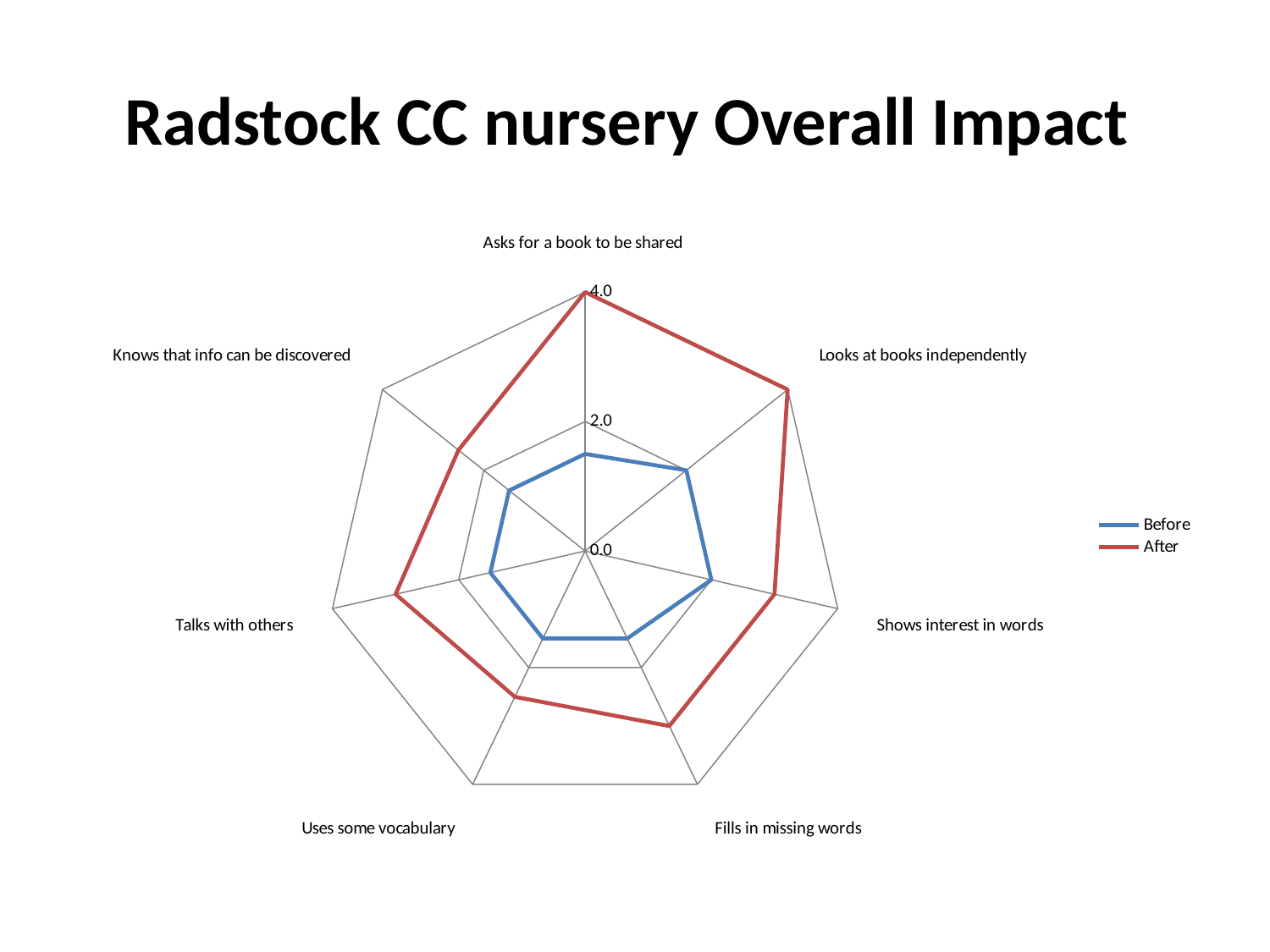
How many series does the legend list? 2 Is the After value for "Talks with others" greater or less than 4.0? less For "Fills in missing words", which series has the larger value, Before or After? After How many categories (axes) does the radar chart have? 7 Which category has the highest After value? Asks for a book to be shared and Looks at books independently (tied at 4.0) What kind of chart is shown on the slide? Radar chart Which After value is larger: "Asks for a book to be shared" or "Uses some vocabulary"? Asks for a book to be shared Which colour represents the After series in the legend? Red What is the After value for "Asks for a book to be shared"? 4.0 What is the title of the slide? Radstock CC nursery Overall Impact Is the After value for "Shows interest in words" greater or less than 2.0? greater